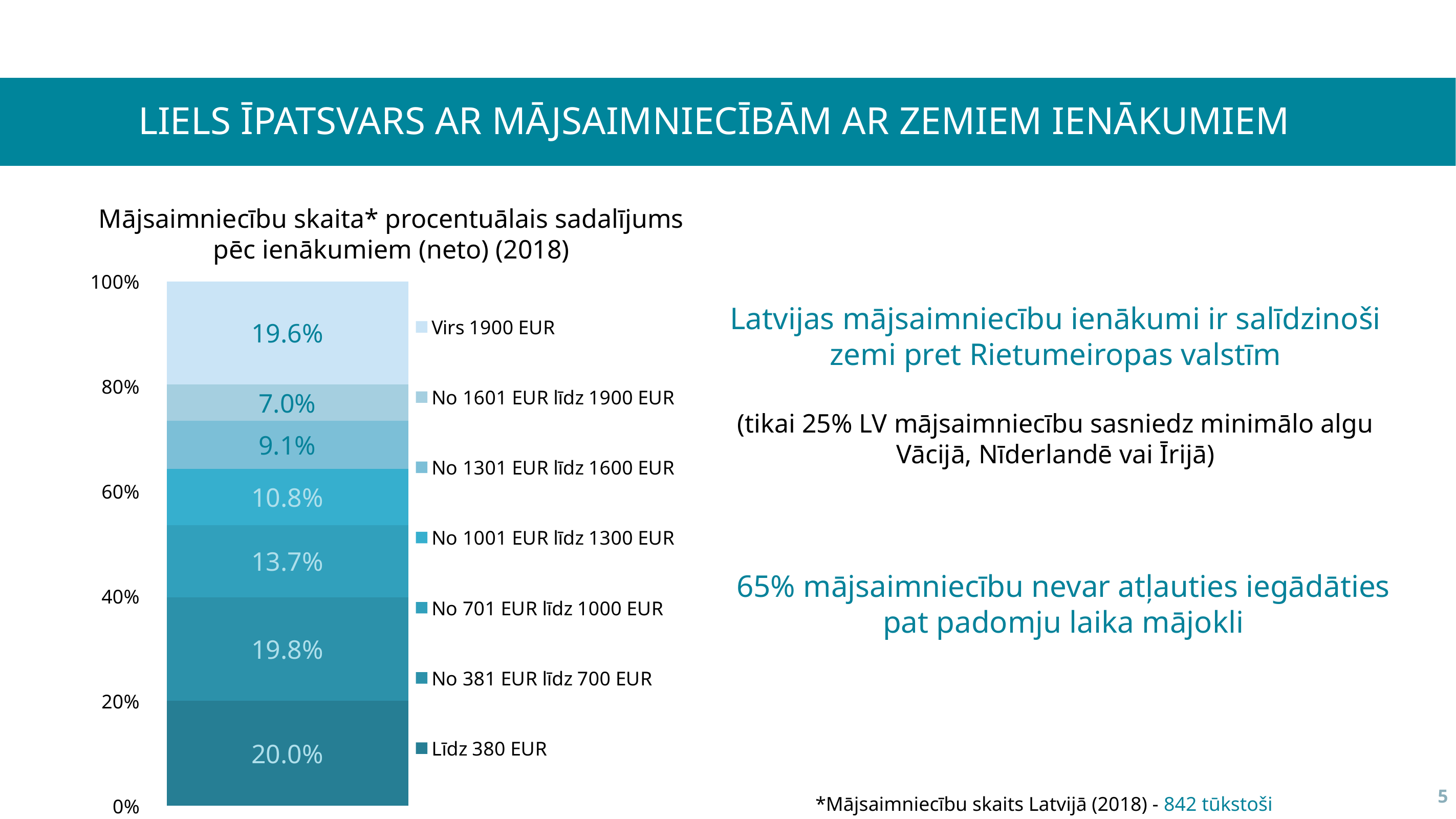
What percentage of households is in the 'No 1001 EUR līdz 1300 EUR' income group? 10.8% Which is larger: the share for 'No 381 EUR līdz 700 EUR' or the share for 'No 701 EUR līdz 1000 EUR'? No 381 EUR līdz 700 EUR Which income group has the largest share of households? Līdz 380 EUR What percentage of households is in the 'Līdz 380 EUR' income group? 20.0% What is the difference in percentage points between the 'Līdz 380 EUR' group and the 'No 1601 EUR līdz 1900 EUR' group? 13.0 percentage points Which income group has the smallest share of households? No 1601 EUR līdz 1900 EUR What percentage of households is in the 'Virs 1900 EUR' income group? 19.6% What is the title of the chart? Mājsaimniecību skaita* procentuālais sadalījums pēc ienākumiem (neto) (2018) What percentage of households is in the 'No 1601 EUR līdz 1900 EUR' income group? 7.0% How many income groups are shown in the legend? 7 What type of chart is shown on the slide? Stacked bar chart What is the total of all segments in the stacked bar? 100.0%